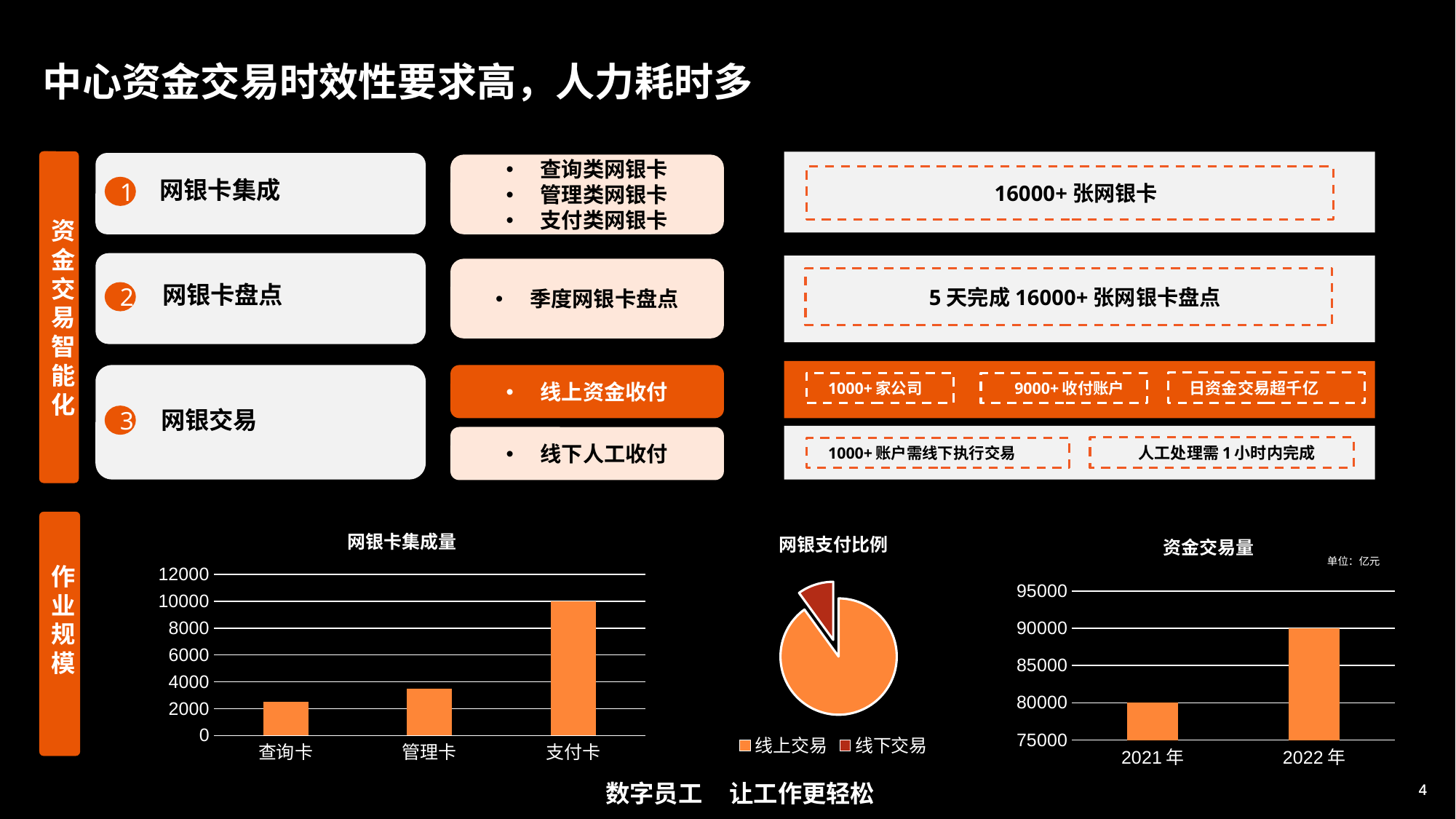
In the 资金交易量 chart, what is the value for 2022 年? 90000 In the 资金交易量 chart, what is the difference between 2022 年 and 2021 年? 10000 In the 网银卡集成量 chart, which category has the lowest value? 查询卡 In the 网银支付比例 chart, which slice is larger, 线上交易 or 线下交易? 线上交易 In the 网银卡集成量 chart, is the value for 查询卡 greater or less than 4000? less How many series does the legend of the 网银支付比例 chart list? 2 What kind of chart is the 网银支付比例 chart? pie chart How many categories are shown in the 网银卡集成量 chart? 3 In the 资金交易量 chart, do the values rise or fall from 2021 年 to 2022 年? rise In the 网银卡集成量 chart, what is the value for 支付卡? 10000 In the 网银卡集成量 chart, is the value for 管理卡 greater or less than 2000? greater In the 网银卡集成量 chart, which category has the highest value? 支付卡